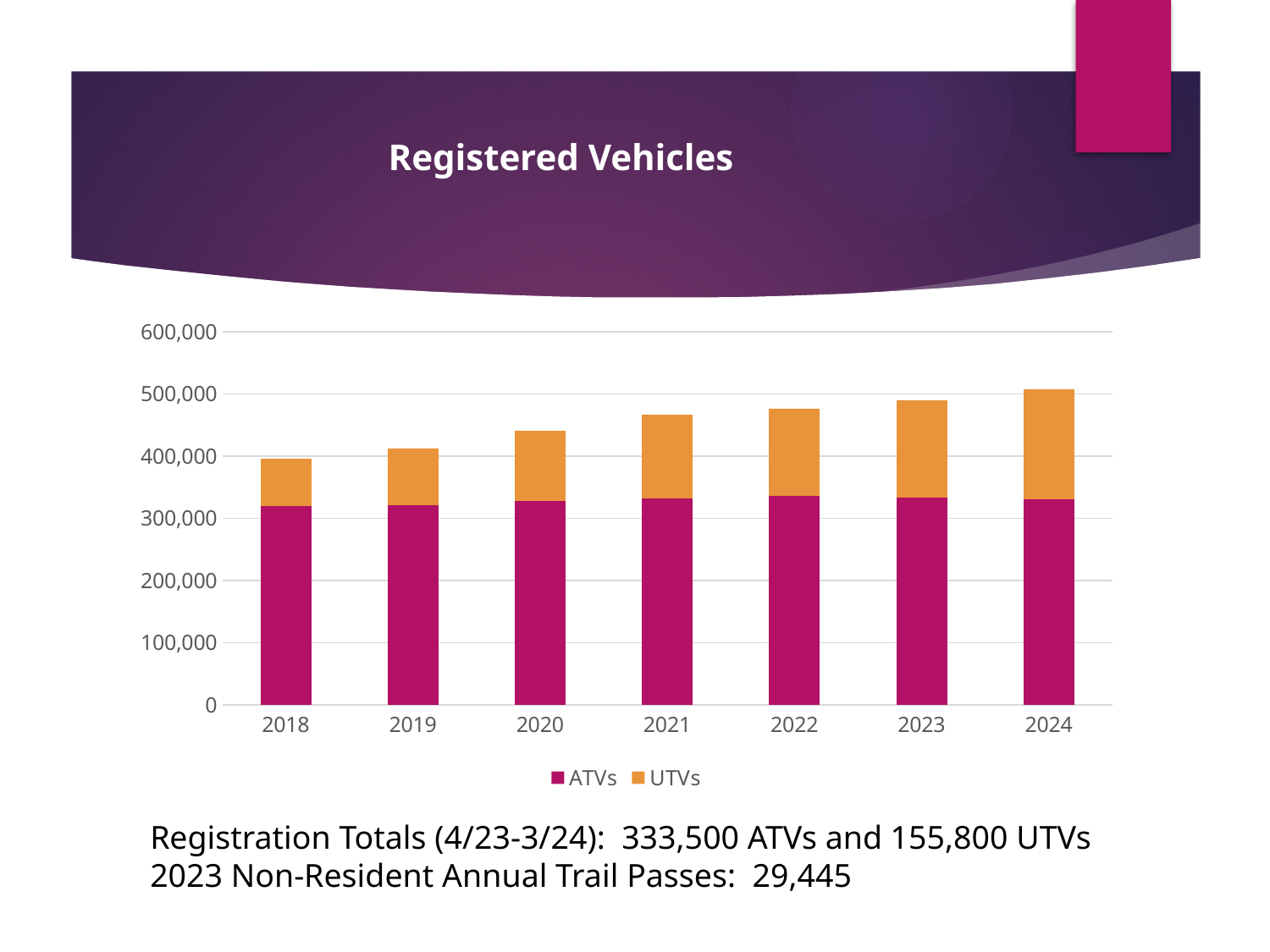
Which year has the larger UTVs segment, 2018 or 2024? 2024 Is the ATVs value for 2021 greater or less than 300,000? greater How many series does the legend list? 2 Which colour represents UTVs in the chart? Orange Is the total registered vehicles for 2022 greater or less than 500,000? less What is the title of the chart? Registered Vehicles Is the total registered vehicles for 2020 greater or less than 400,000? greater Which year has the highest total registered vehicles? 2024 Do total registered vehicles rise or fall from 2018 to 2024? Rise How many years are shown on the x axis? 7 What kind of chart is shown on the slide? Stacked bar chart Which year has the lowest total registered vehicles? 2018